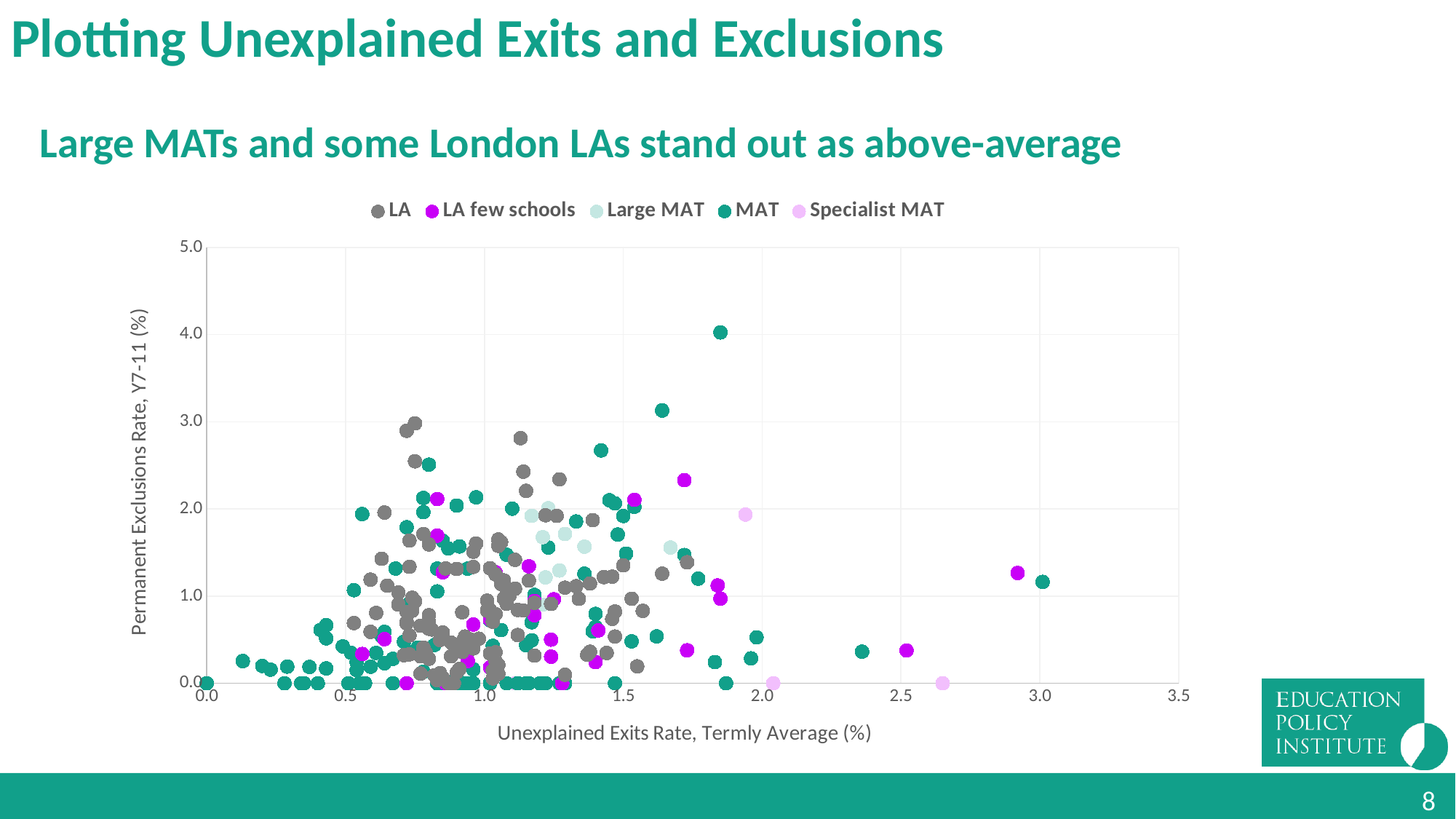
What kind of chart is shown on the slide? scatter chart What is the title of the x axis? Unexplained Exits Rate, Termly Average (%) Which series contains the point with the highest Unexplained Exits Rate? MAT Is the Unexplained Exits Rate of the LA few schools point furthest to the right greater or less than 2.5? greater Which series contains the point with the highest Permanent Exclusions Rate? MAT How many series does the legend list? 5 Is the highest Permanent Exclusions Rate plotted on the chart greater or less than 3.5? greater Is the largest Unexplained Exits Rate plotted on the chart greater or less than 2.5? greater What are the series names listed in the legend? LA, LA few schools, Large MAT, MAT, Specialist MAT